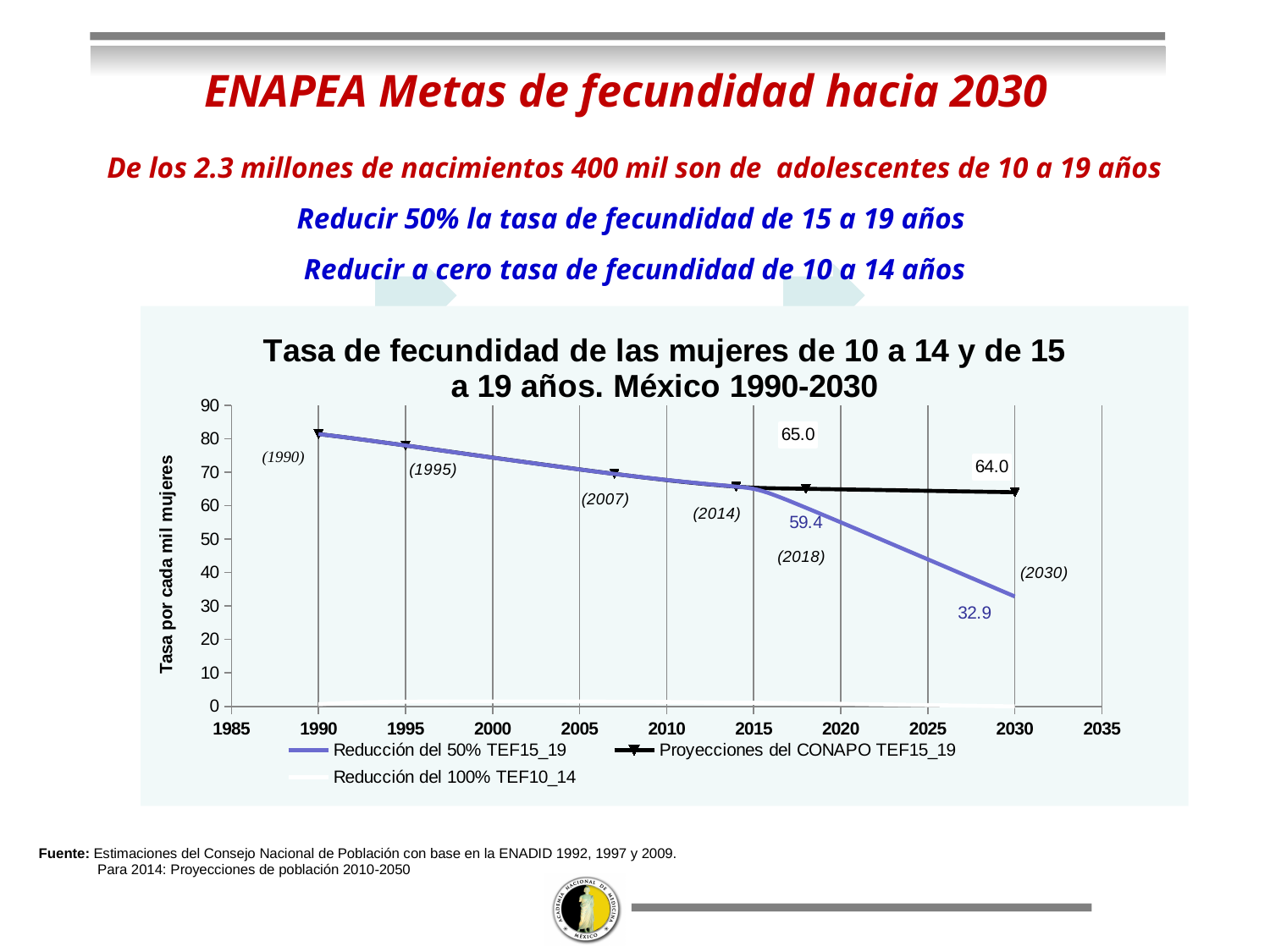
How many series does the chart legend list? 3 Does the Reducción del 50% TEF15_19 line rise or fall from 1990 to 2030? fall What is the value of the Proyecciones del CONAPO TEF15_19 series in 2030? 64.0 What is the value of the Reducción del 50% TEF15_19 series in 2030? 32.9 What is the value of the Proyecciones del CONAPO TEF15_19 series in 2018? 65.0 What kind of chart is shown on the slide? line chart What is the difference between the Proyecciones del CONAPO TEF15_19 value and the Reducción del 50% TEF15_19 value in 2018? 5.6 What is the difference between the Proyecciones del CONAPO TEF15_19 value and the Reducción del 50% TEF15_19 value in 2030? 31.1 Is the value of the TEF15_19 line in 1990 greater or less than 70? greater In 2030, which series has the higher value: Reducción del 50% TEF15_19 or Proyecciones del CONAPO TEF15_19? Proyecciones del CONAPO TEF15_19 What is the title of the chart? Tasa de fecundidad de las mujeres de 10 a 14 y de 15 a 19 años. México 1990-2030 What is the value of the Reducción del 50% TEF15_19 series in 2018? 59.4